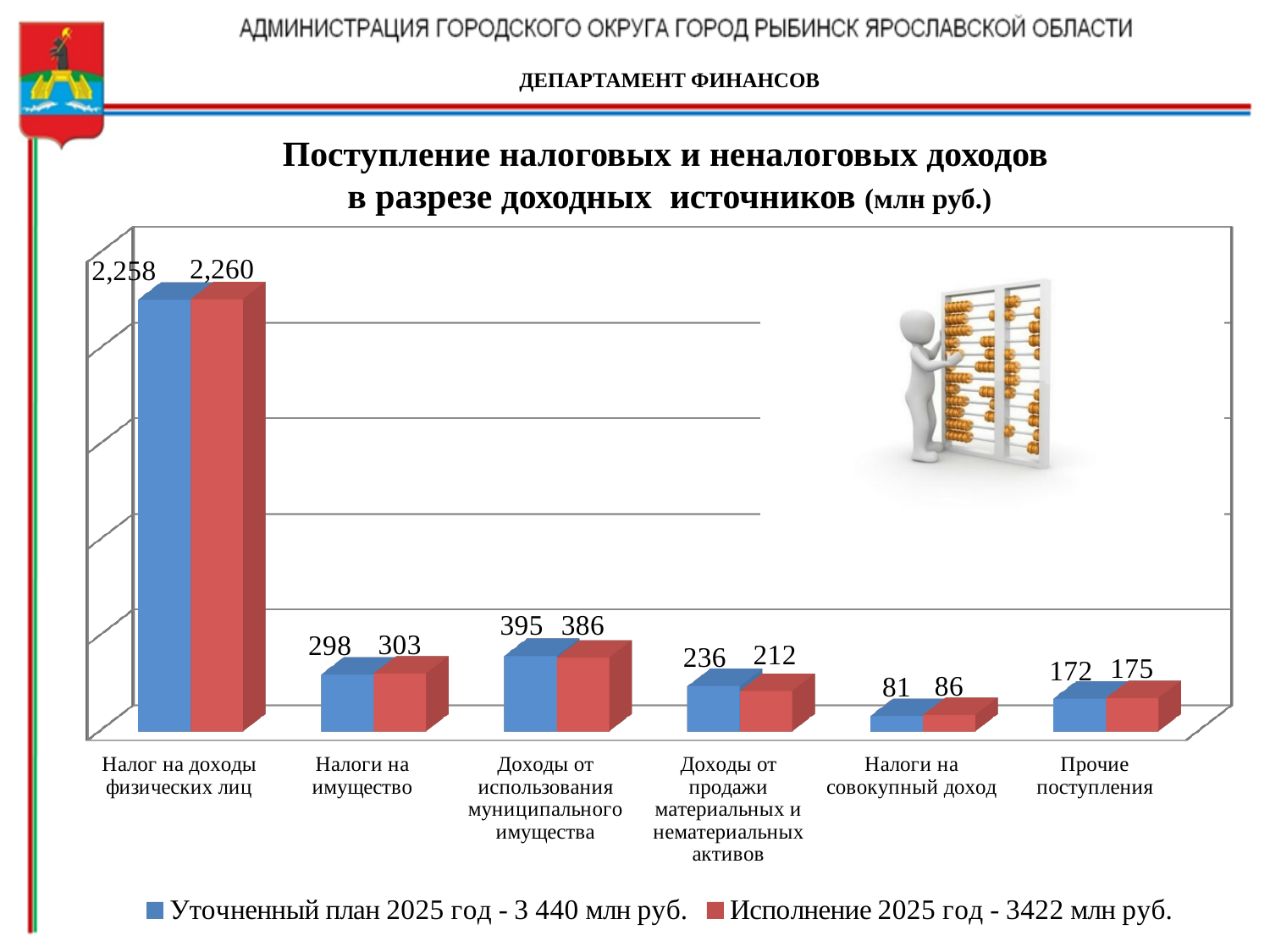
How many series does the legend list? 2 What is the value of Уточненный план 2025 год for Налог на доходы физических лиц? 2,258 What colour represents the Исполнение 2025 год series? Red What is the value of Исполнение 2025 год for Налоги на совокупный доход? 86 Which category has the highest value for Исполнение 2025 год? Налог на доходы физических лиц How many categories are shown on the x axis? 6 What is the difference between Уточненный план 2025 год and Исполнение 2025 год for Доходы от продажи материальных и нематериальных активов? 24 What is the value of Исполнение 2025 год for Доходы от использования муниципального имущества? 386 Which category has the lowest value for Уточненный план 2025 год? Налоги на совокупный доход What is the value of Уточненный план 2025 год for Прочие поступления? 172 Which is larger for Налоги на имущество: Уточненный план 2025 год or Исполнение 2025 год? Исполнение 2025 год What kind of chart is shown on the slide? Bar chart